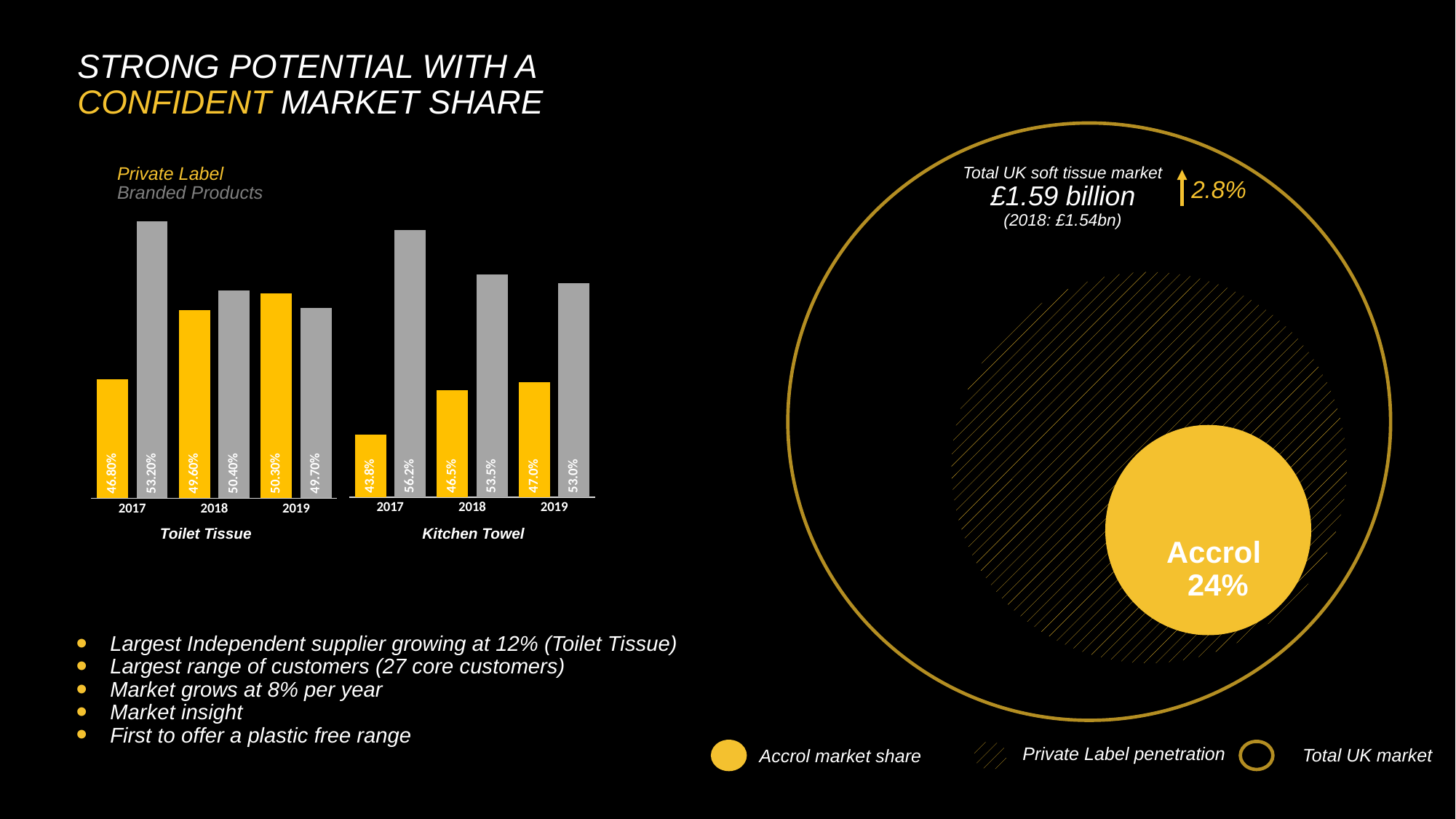
In the bar chart, what is the Private Label value for Kitchen Towel in 2019? 47.0% In the circle diagram on the right, what market share is shown for Accrol? 24% In the bar chart, what is the Private Label value for Toilet Tissue in 2017? 46.80% In the bar chart, which year has the highest Private Label value for Toilet Tissue? 2019 In the bar chart, for Kitchen Towel in 2018, which is larger: Private Label or Branded Products? Branded Products How many series does the bar chart's legend list? 2 In the bar chart, which year has the lowest Private Label value for Kitchen Towel? 2017 In the bar chart, what is the Branded Products value for Toilet Tissue in 2019? 49.70% In the bar chart, does the Private Label value for Toilet Tissue rise or fall from 2017 to 2019? rise What type of chart is used to show Private Label and Branded Products shares for Toilet Tissue and Kitchen Towel? bar chart In the bar chart, what is the difference between the Branded Products and Private Label values for Toilet Tissue in 2017? 6.40% In the bar chart, what is the Branded Products value for Kitchen Towel in 2017? 56.2%